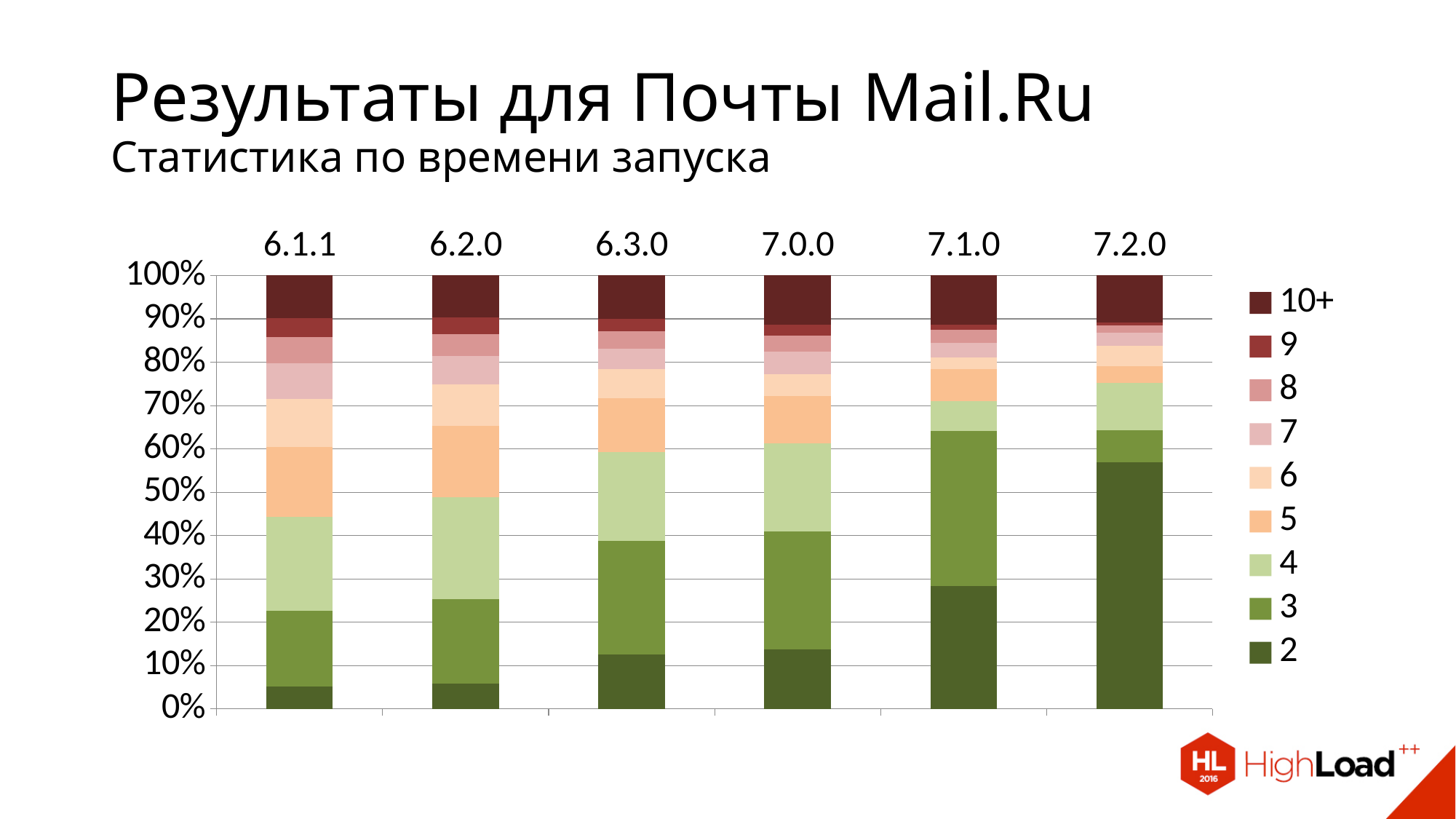
Is the share of series "2" for version 7.2.0 greater or less than 50%? greater Is the share of series "2" for version 6.1.1 greater or less than 10%? less Which has the larger share of series "2": version 6.2.0 or version 7.0.0? 7.0.0 What is the total height of each stacked bar? 100% What is the subtitle of the slide above the chart? Статистика по времени запуска Which version has the largest share for series "2"? 7.2.0 How many versions (categories) are plotted along the x axis? 6 Does the share of series "2" rise or fall from version 6.1.1 to version 7.2.0? rise Is the share of series "2" for version 7.1.0 greater or less than 20%? greater Which legend entry is listed first (at the top) in the legend? 10+ How many series does the legend list? 9 What kind of chart is shown on the slide? Stacked bar chart